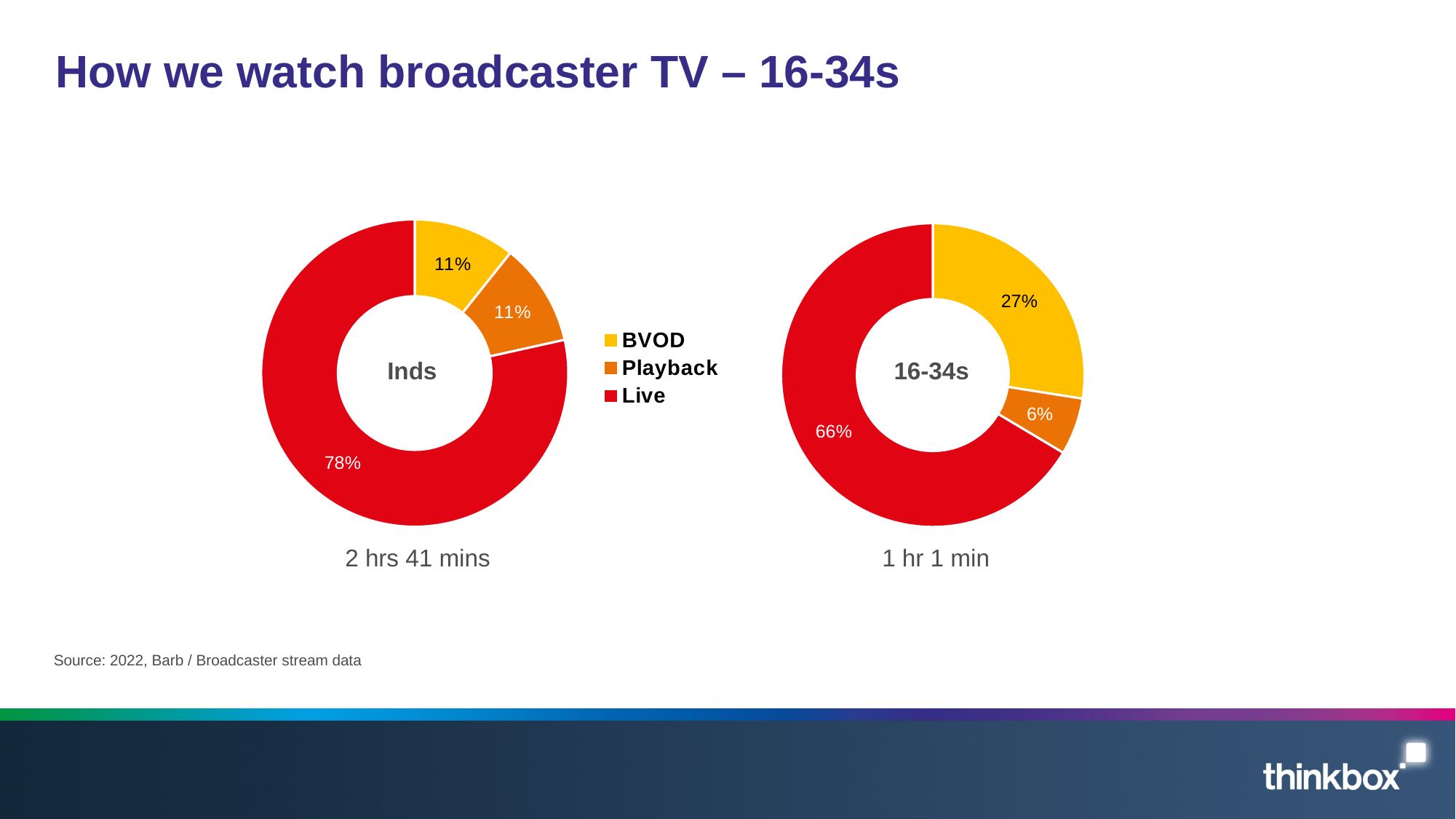
What type of chart is used on this slide? Doughnut (pie) chart In the 16-34s doughnut chart, what share is Playback? 6% What total viewing time is shown beneath the 16-34s chart? 1 hr 1 min In the Inds doughnut chart, what share is Live? 78% What is the difference between the Live share in the Inds chart and the Live share in the 16-34s chart? 12 percentage points What total viewing time is shown beneath the Inds chart? 2 hrs 41 mins Is the BVOD share larger in the Inds chart or the 16-34s chart? 16-34s In the 16-34s doughnut chart, which category has the largest share? Live In the Inds doughnut chart, what share is BVOD? 11% How many categories does the legend list? 3 In the 16-34s doughnut chart, what share is BVOD? 27% In the 16-34s doughnut chart, which category has the smallest share? Playback